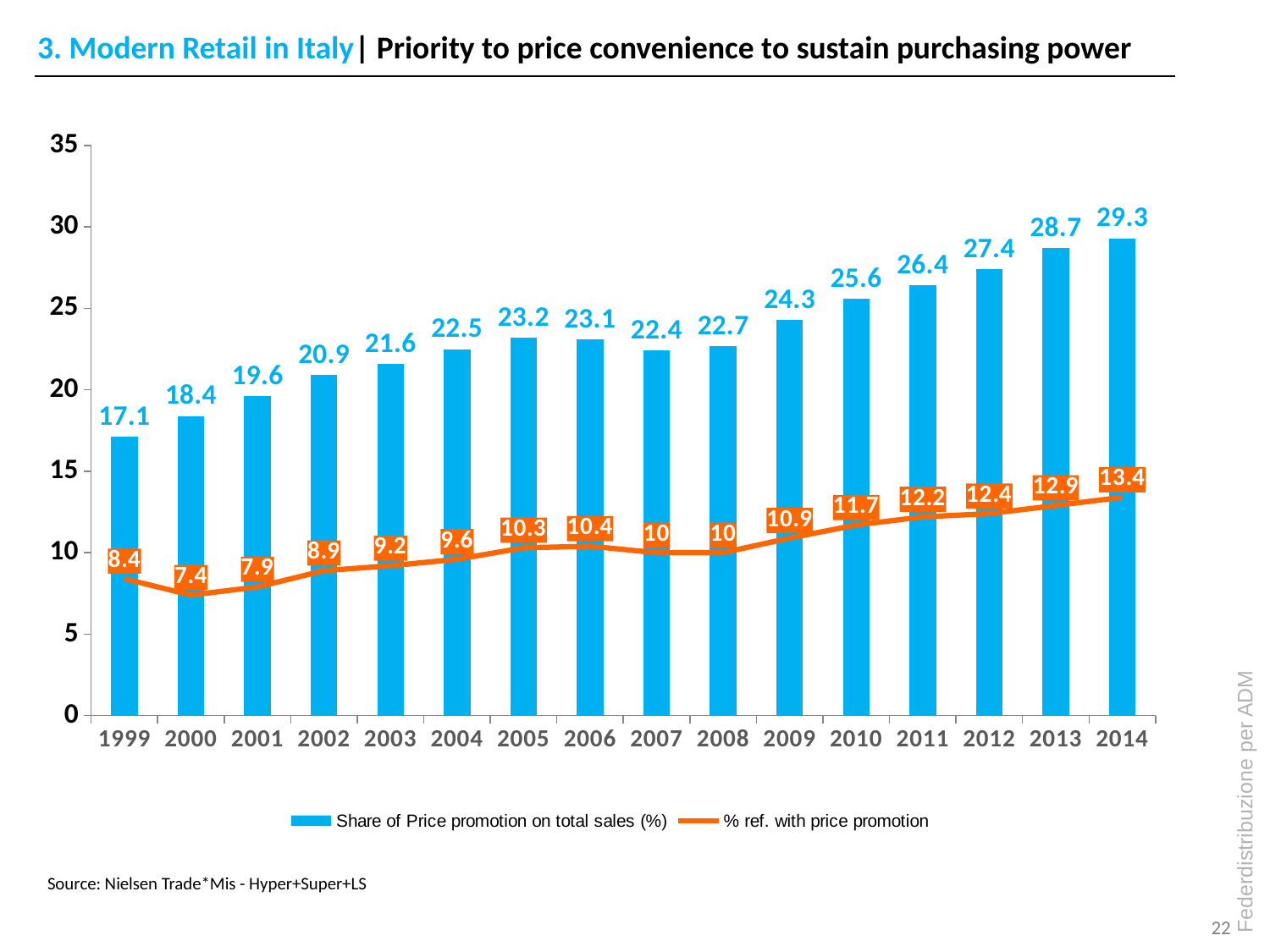
Is the Share of Price promotion on total sales (%) larger in 2006 or in 2007? 2006 What is the difference between the Share of Price promotion on total sales (%) in 2014 and in 1999? 12.2 What is the Share of Price promotion on total sales (%) in 2014? 29.3 How many series does the legend list? 2 What is the value of % ref. with price promotion in 2000? 7.4 How many years are shown on the x axis? 16 Which year has the highest Share of Price promotion on total sales (%)? 2014 Which year has the lowest value of % ref. with price promotion? 2000 Does the % ref. with price promotion generally rise or fall from 2000 to 2014? Rise What kind of chart is shown on the slide? Combined bar and line chart What colour are the bars for Share of Price promotion on total sales (%)? Blue What is the Share of Price promotion on total sales (%) in 2005? 23.2